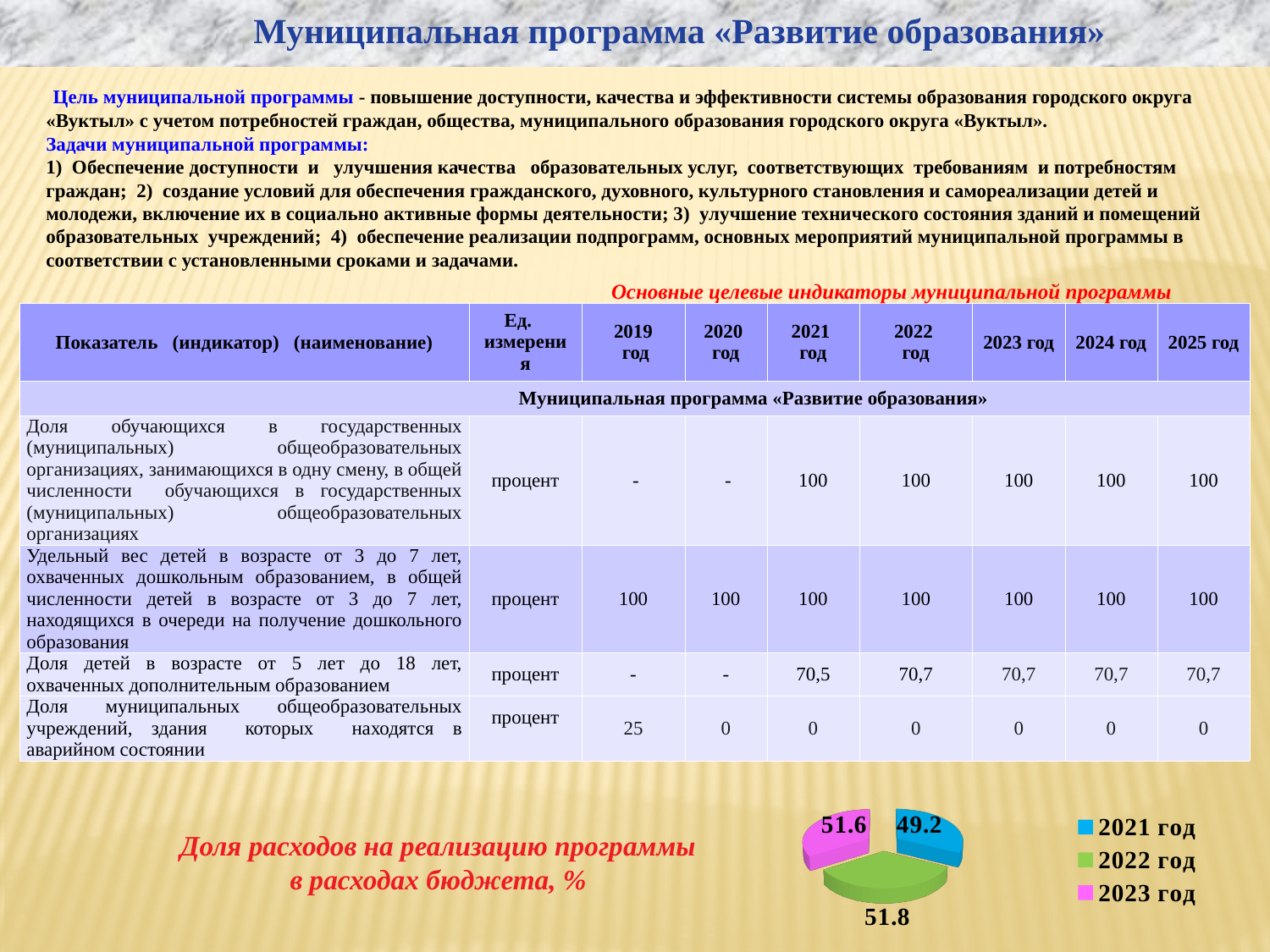
In the pie chart "Доля расходов на реализацию программы в расходах бюджета, %", what is the difference between the values for 2022 год and 2021 год? 2.6 What kind of chart is shown at the bottom of the slide under the heading "Доля расходов на реализацию программы в расходах бюджета, %"? pie chart In the pie chart "Доля расходов на реализацию программы в расходах бюджета, %", what is the value for 2021 год? 49.2 How many entries does the legend of the pie chart "Доля расходов на реализацию программы в расходах бюджета, %" list? 3 In the pie chart "Доля расходов на реализацию программы в расходах бюджета, %", what is the value for 2023 год? 51.6 How many slices does the pie chart "Доля расходов на реализацию программы в расходах бюджета, %" have? 3 In the pie chart "Доля расходов на реализацию программы в расходах бюджета, %", what is the difference between the values for 2023 год and 2021 год? 2.4 In the pie chart "Доля расходов на реализацию программы в расходах бюджета, %", what colour is the slice for 2022 год? green In the pie chart "Доля расходов на реализацию программы в расходах бюджета, %", which year has the highest value? 2022 год In the pie chart "Доля расходов на реализацию программы в расходах бюджета, %", what is the value for 2022 год? 51.8 In the pie chart "Доля расходов на реализацию программы в расходах бюджета, %", which is larger: the value for 2021 год or the value for 2023 год? 2023 год In the pie chart "Доля расходов на реализацию программы в расходах бюджета, %", which year has the lowest value? 2021 год